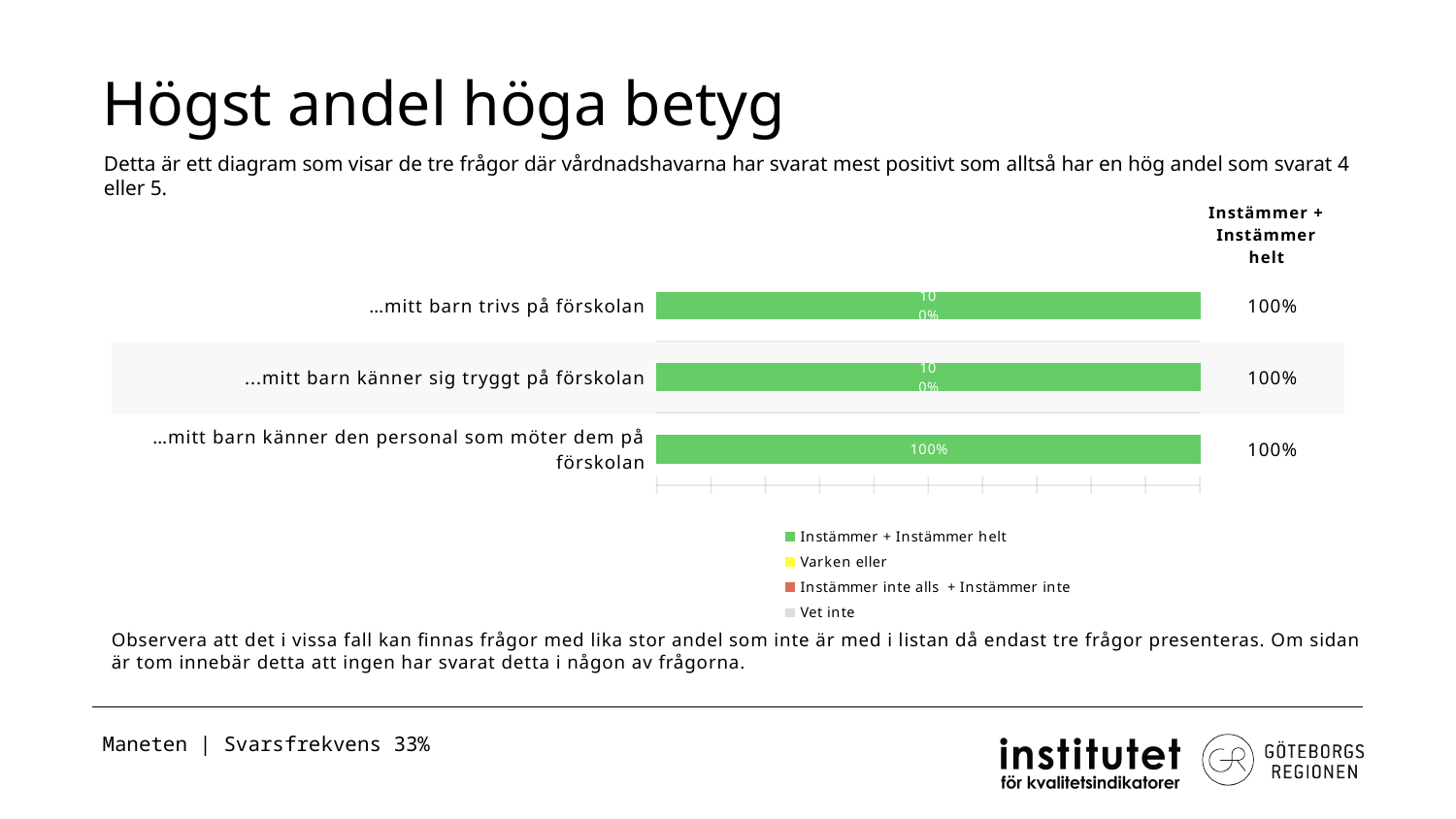
Which legend entry is shown in green? Instämmer + Instämmer helt Is the value for '...mitt barn känner sig tryggt på förskolan' greater or less than 50%? greater What is the 'Instämmer + Instämmer helt' value for '…mitt barn känner den personal som möter dem på förskolan'? 100% What is the difference between the 'Instämmer + Instämmer helt' values for '…mitt barn trivs på förskolan' and '…mitt barn känner den personal som möter dem på förskolan'? 0% What is the heading of the column of values to the right of the bars? Instämmer + Instämmer helt How many series does the legend list? 4 What is the 'Instämmer + Instämmer helt' value for '…mitt barn trivs på förskolan'? 100% What kind of chart is shown on the slide? bar chart What is the 'Instämmer + Instämmer helt' value for '...mitt barn känner sig tryggt på förskolan'? 100% What is the title of the slide containing the chart? Högst andel höga betyg How many categories (questions) are plotted in the chart? 3